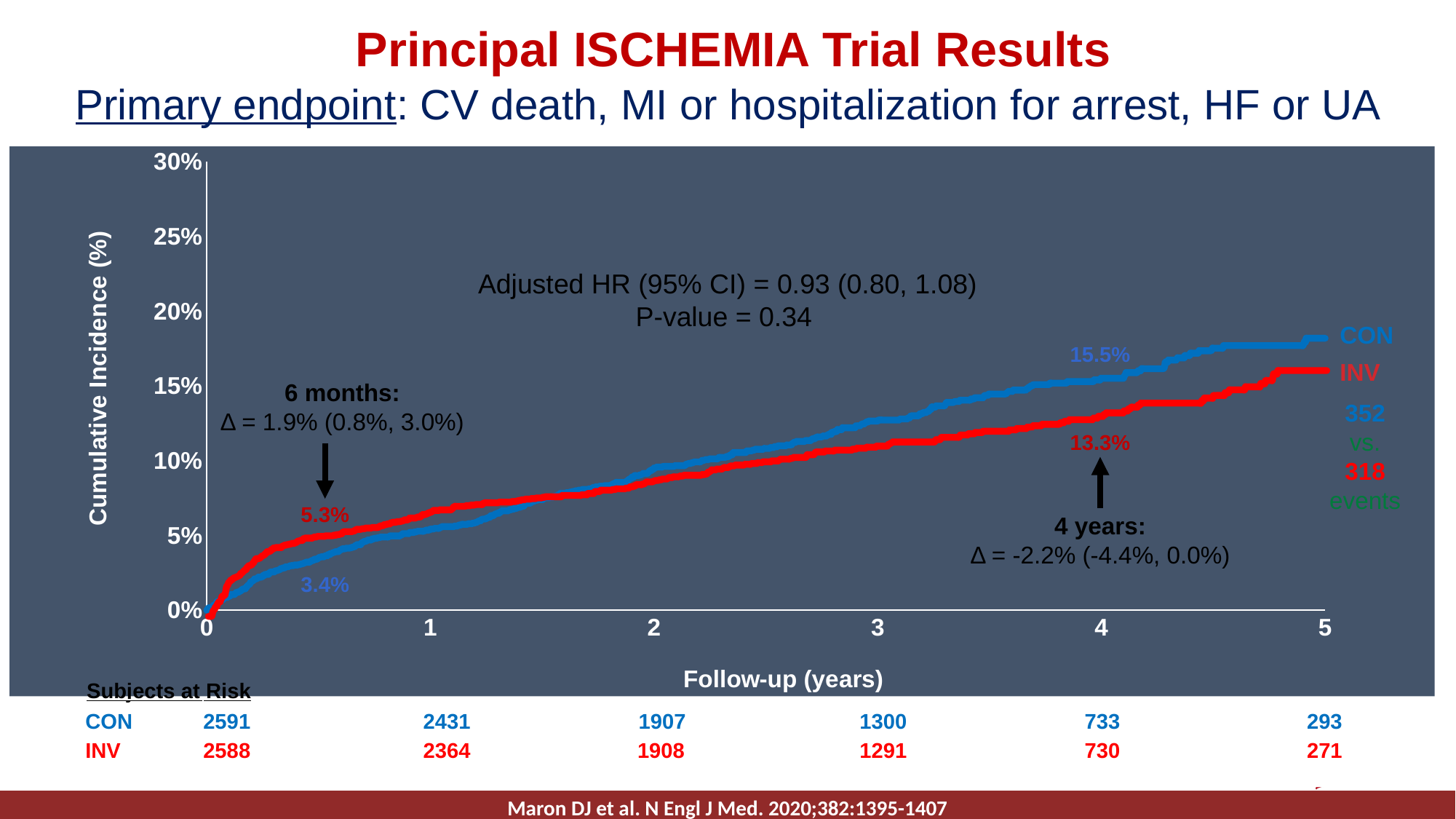
What is the difference between the CON and INV cumulative incidence at 4 years? 2.2% Is the cumulative incidence for the CON group at 5 years greater or less than 15%? greater What is the cumulative incidence for the CON group at 6 months? 3.4% What is the cumulative incidence for the CON group at 4 years? 15.5% What is the cumulative incidence for the INV group at 4 years? 13.3% What is the cumulative incidence for the INV group at 6 months? 5.3% At 4 years, which group has the higher cumulative incidence, CON or INV? CON What type of chart is shown on the slide? Line chart At 6 months, which group has the higher cumulative incidence, CON or INV? INV How many series are plotted on the chart? 2 What is the adjusted hazard ratio with 95% CI shown on the chart? 0.93 (0.80, 1.08) Do the cumulative incidence curves rise or fall as follow-up time increases? Rise